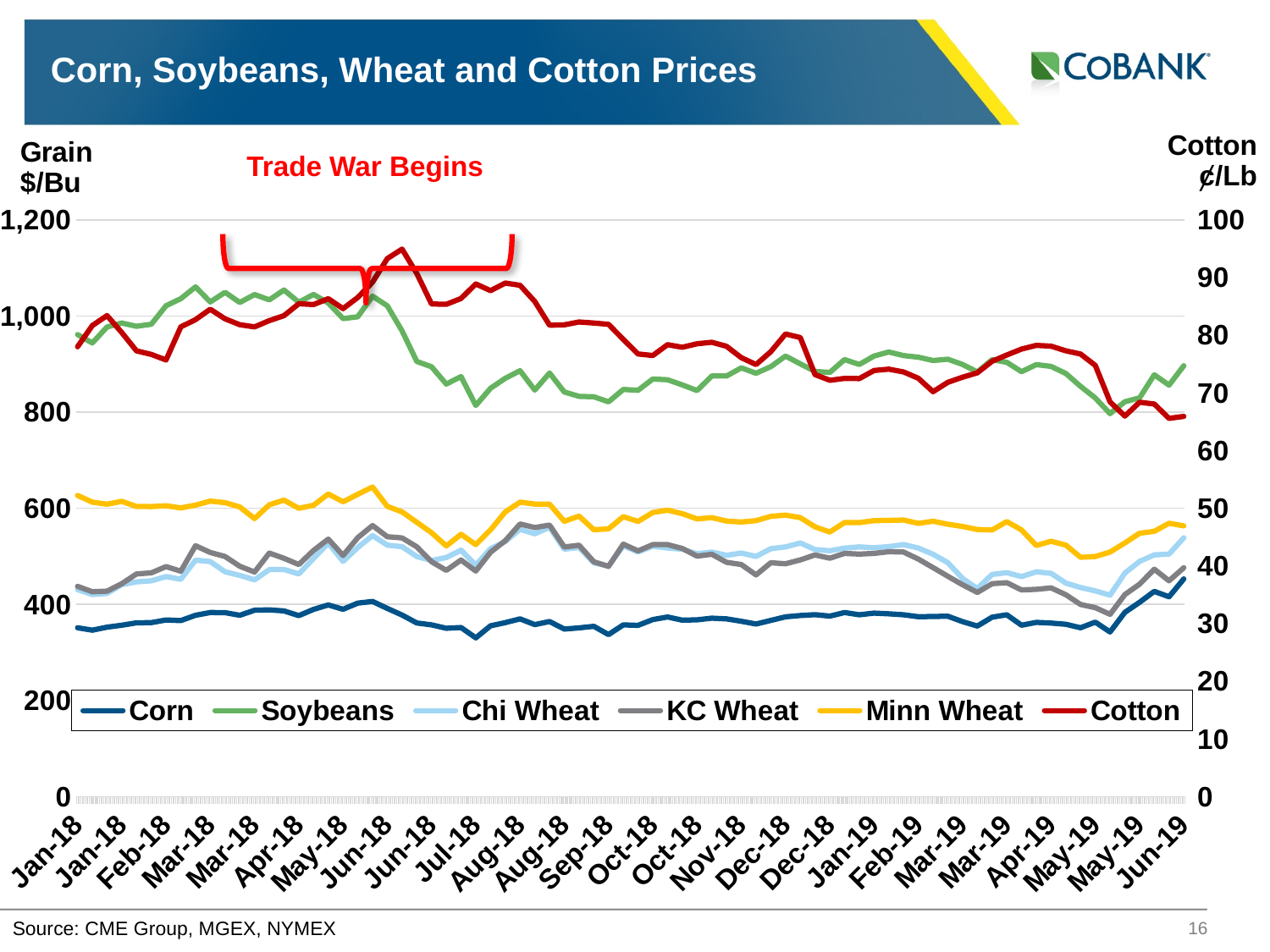
What kind of chart is shown on the slide? Line chart Is the value for Corn in Jan-18 greater or less than 400? less Which grain series has the lowest price on the left axis across the chart? Corn How many series does the legend list? 6 Do Soybeans prices rise or fall from Jun-18 to Jul-18? fall Is the value for Cotton in Jun-19 greater or less than 70? less What annotation is written in red above the chart? Trade War Begins Which is higher in Jan-18, Minn Wheat or KC Wheat? Minn Wheat Is the value for Soybeans in Jan-18 greater or less than 800? greater Does the Cotton price rise or fall overall from Jun-18 to Jun-19? fall Which grain series has the highest price on the left axis across the chart? Soybeans What is the title of the chart? Corn, Soybeans, Wheat and Cotton Prices